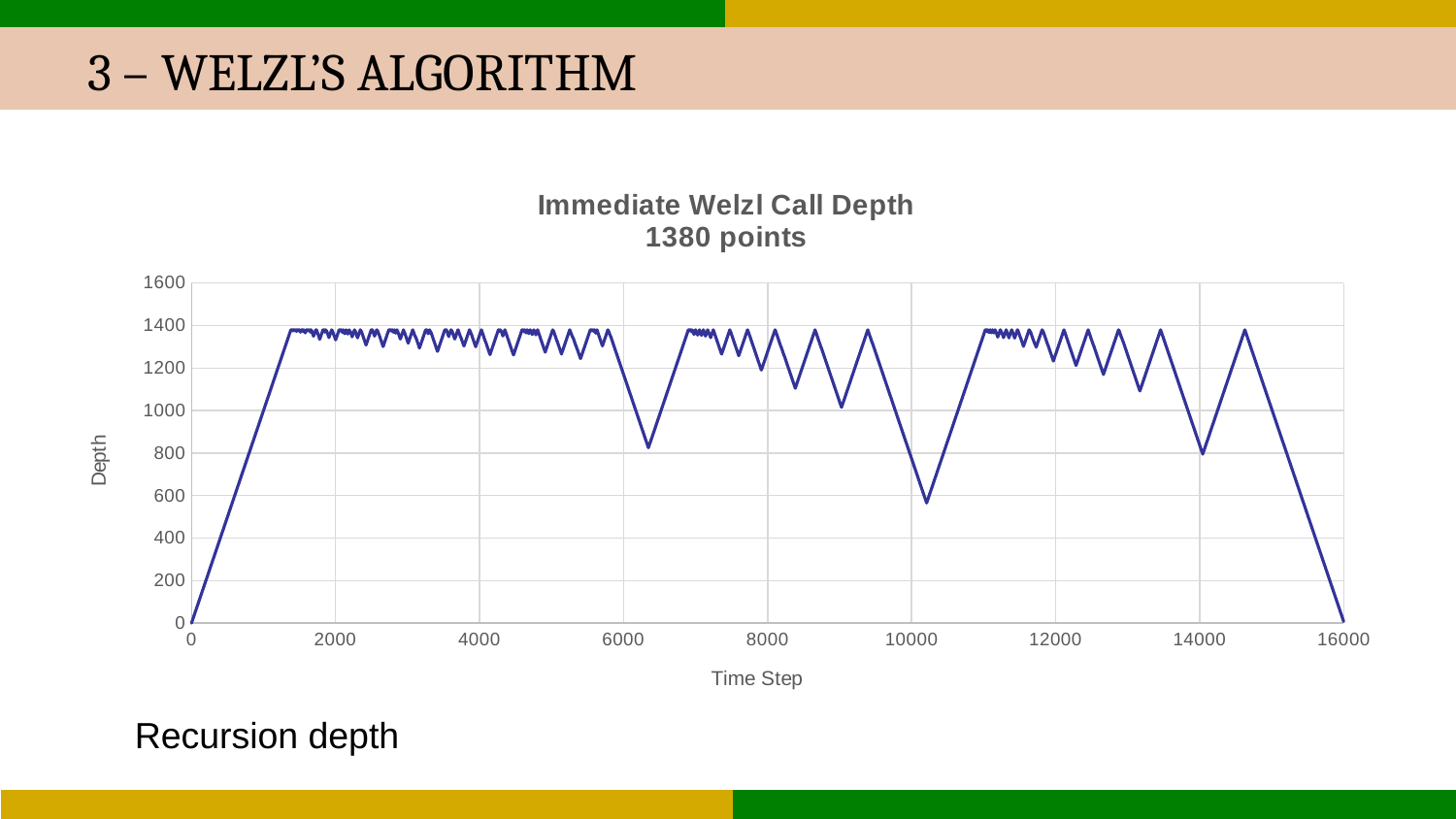
What is the label of the x axis of the chart? Time Step What is the title of the chart? Immediate Welzl Call Depth 1380 points Is the maximum depth reached in the chart greater or less than 1400? less Does the depth rise or fall between time step 0 and time step 1000? rise Is the depth at time step 10000 greater or less than 1000? less What is the depth at time step 16000? 0 Does the depth rise or fall between time step 15000 and time step 16000? fall What is the depth at time step 0? 0 Is the depth at time step 14000 greater or less than 1200? less What kind of chart is shown on the slide? line chart